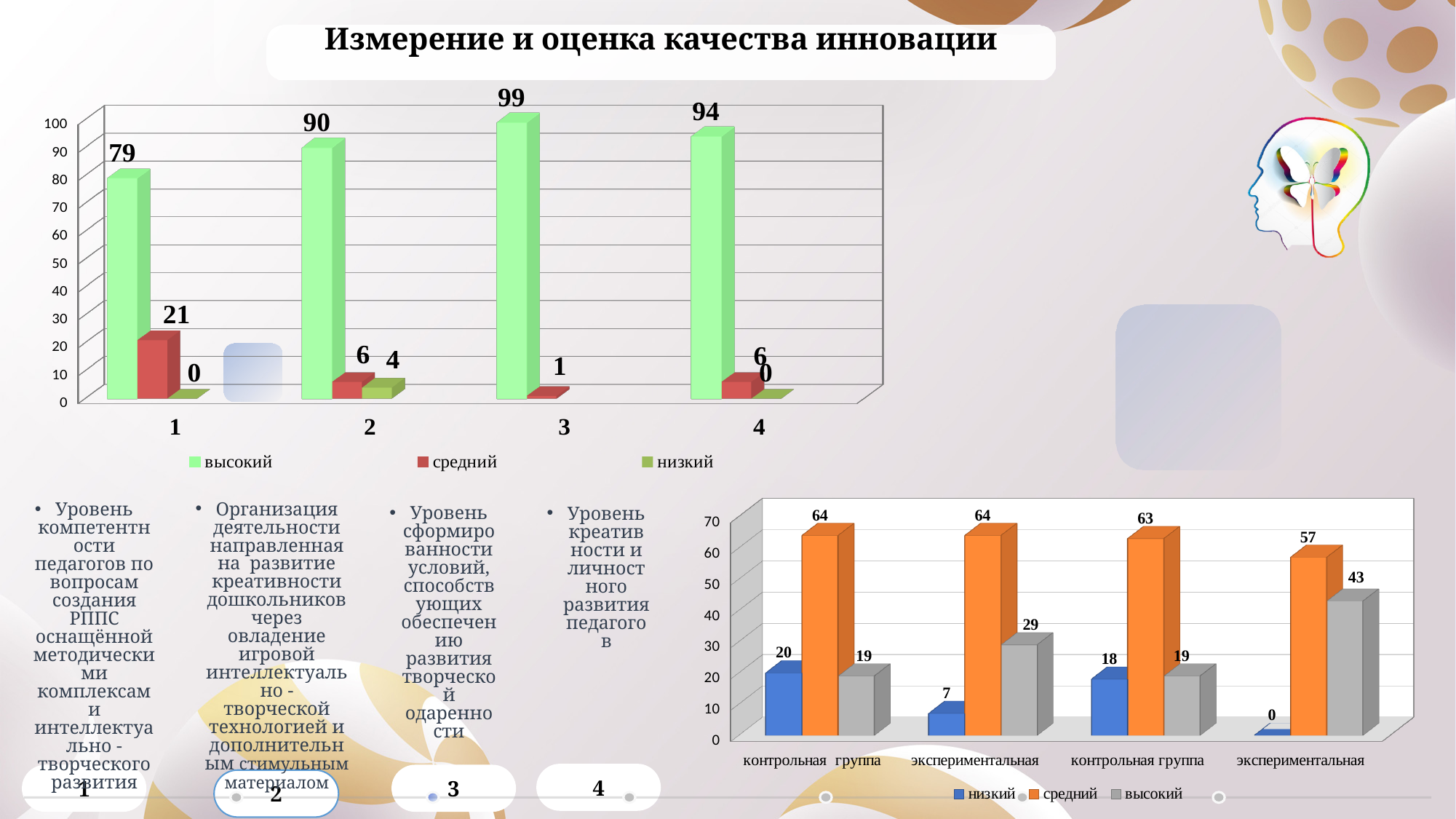
In the top chart, what is the value of the высокий series for category 3? 99 What type of chart is the bottom-right chart? bar chart In the bottom-right chart, what is the средний value for the rightmost экспериментальная group? 57 In the top chart, what is the difference between the высокий values for category 2 and category 1? 11 In the top chart, how many series does the legend list? 3 In the top chart, what is the value of the низкий series for category 2? 4 In the top chart, what is the value of the средний series for category 1? 21 In the bottom-right chart, which group has the lowest низкий value? экспериментальная (rightmost) In the bottom-right chart, what is the высокий value for the rightmost экспериментальная group? 43 In the bottom-right chart, what is the difference between the высокий values of the first экспериментальная group and the first контрольная группа? 10 In the bottom-right chart, which series is shown in orange? средний In the top chart, which category has the highest высокий value? 3